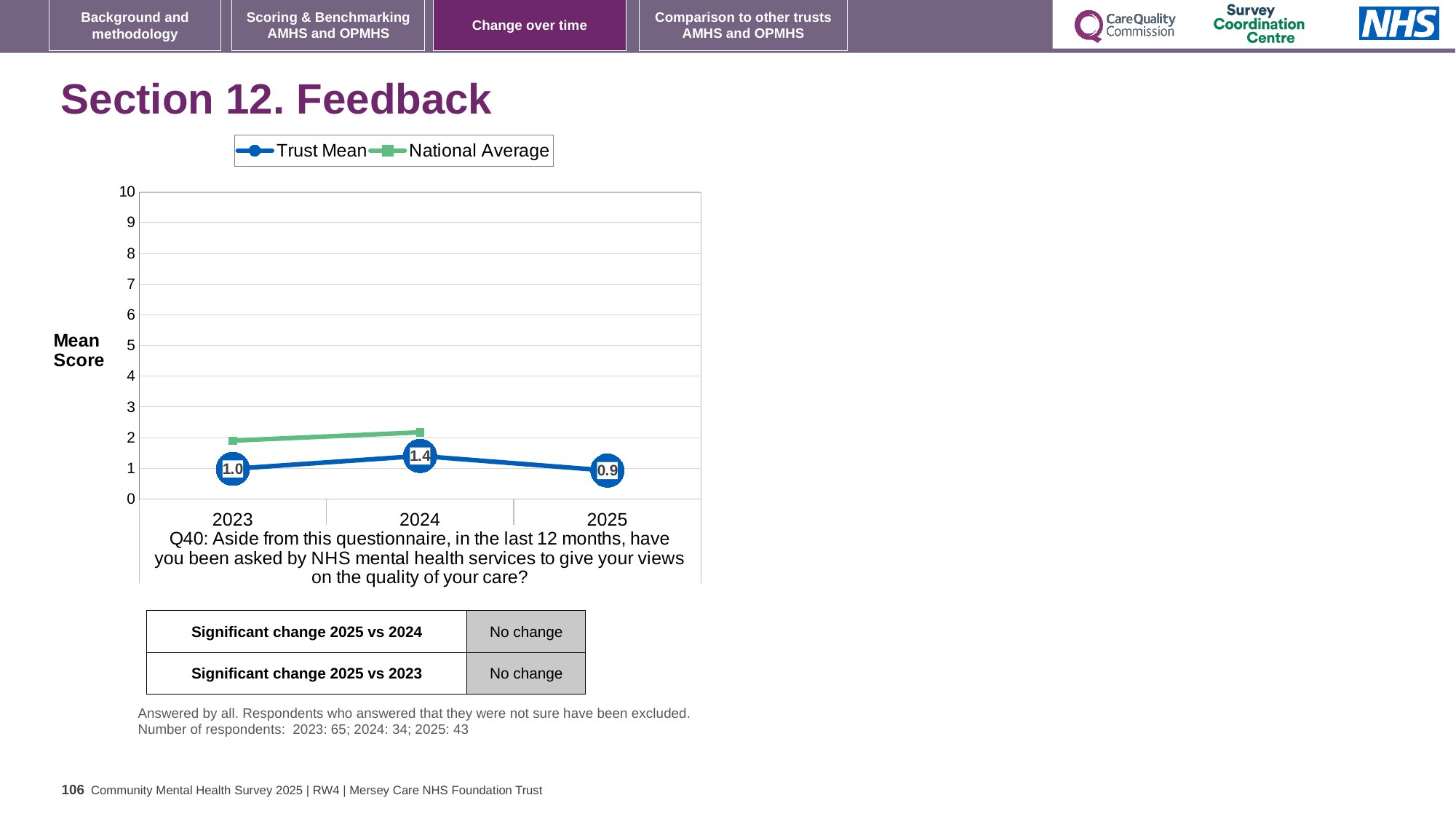
In which year is the Trust Mean highest? 2024 In which year is the Trust Mean lowest? 2025 What is the Trust Mean score for 2024? 1.4 How many series does the legend list? 2 What is the Trust Mean score for 2023? 1.0 Which is larger, the Trust Mean in 2023 or in 2024? 2024 Is the National Average value for 2023 greater or less than 3? less Is the National Average value for 2024 greater or less than 2? greater What kind of chart is shown on the slide? Line chart What is the difference between the Trust Mean in 2024 and in 2025? 0.5 What is the Trust Mean score for 2025? 0.9 How many years are shown on the x axis? 3